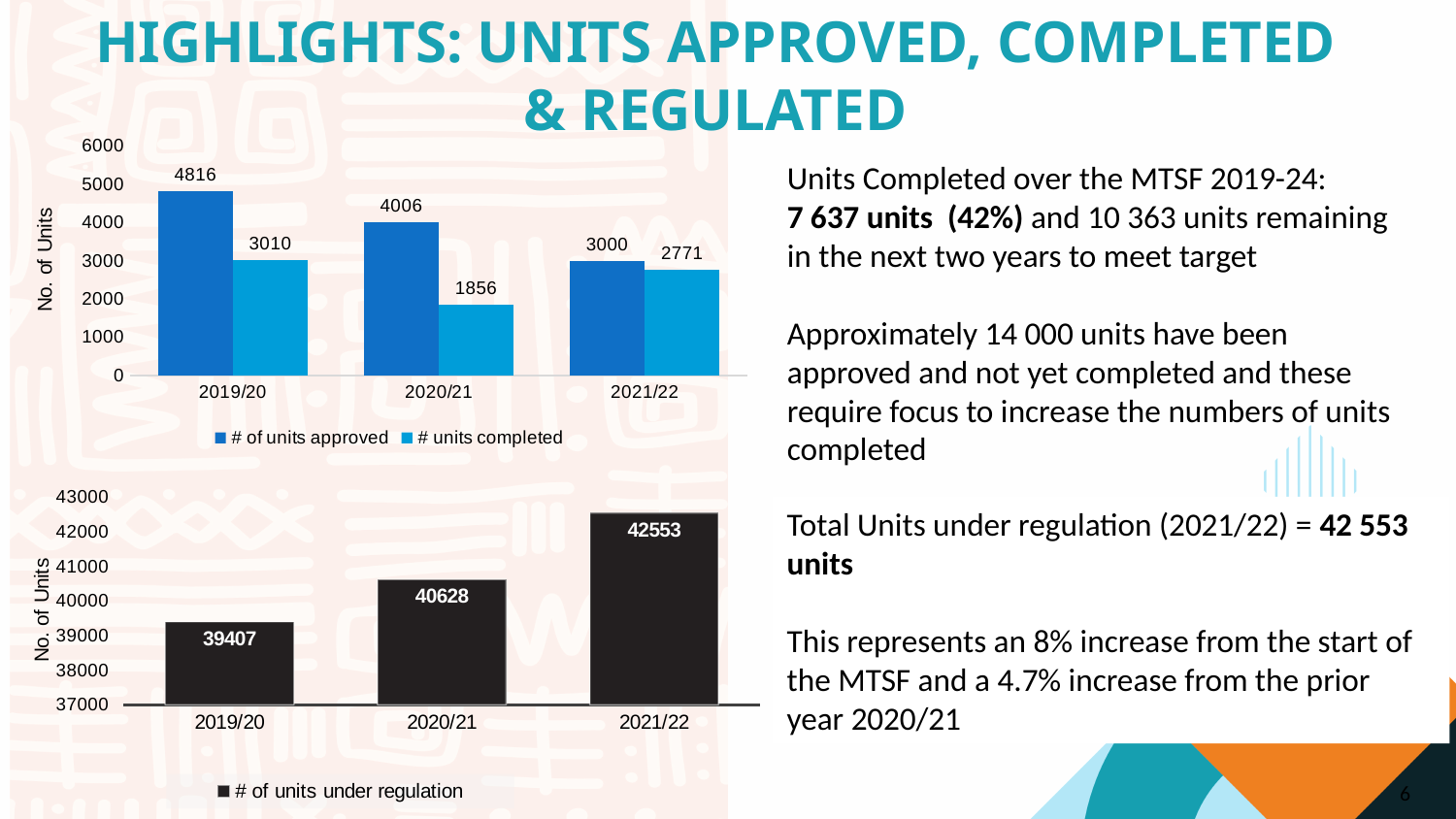
In the top chart, what is the number of units completed in 2020/21? 1856 In the top chart, what is the number of units approved in 2019/20? 4816 In the bottom chart, do the values rise or fall from 2019/20 to 2021/22? rise In the top chart, which year has the highest number of units approved? 2019/20 In the top chart, what is the difference between units approved and units completed in 2021/22? 229 How many series does the legend of the top chart list? 2 In the bottom chart, what is the difference in units under regulation between 2021/22 and 2019/20? 3146 What type of chart is the bottom chart? bar chart How many years are shown on the x axis of the bottom chart? 3 In the top chart, is the number of units completed higher in 2019/20 or in 2021/22? 2019/20 In the top chart, which year has the lowest number of units completed? 2020/21 In the bottom chart, what is the number of units under regulation in 2020/21? 40628